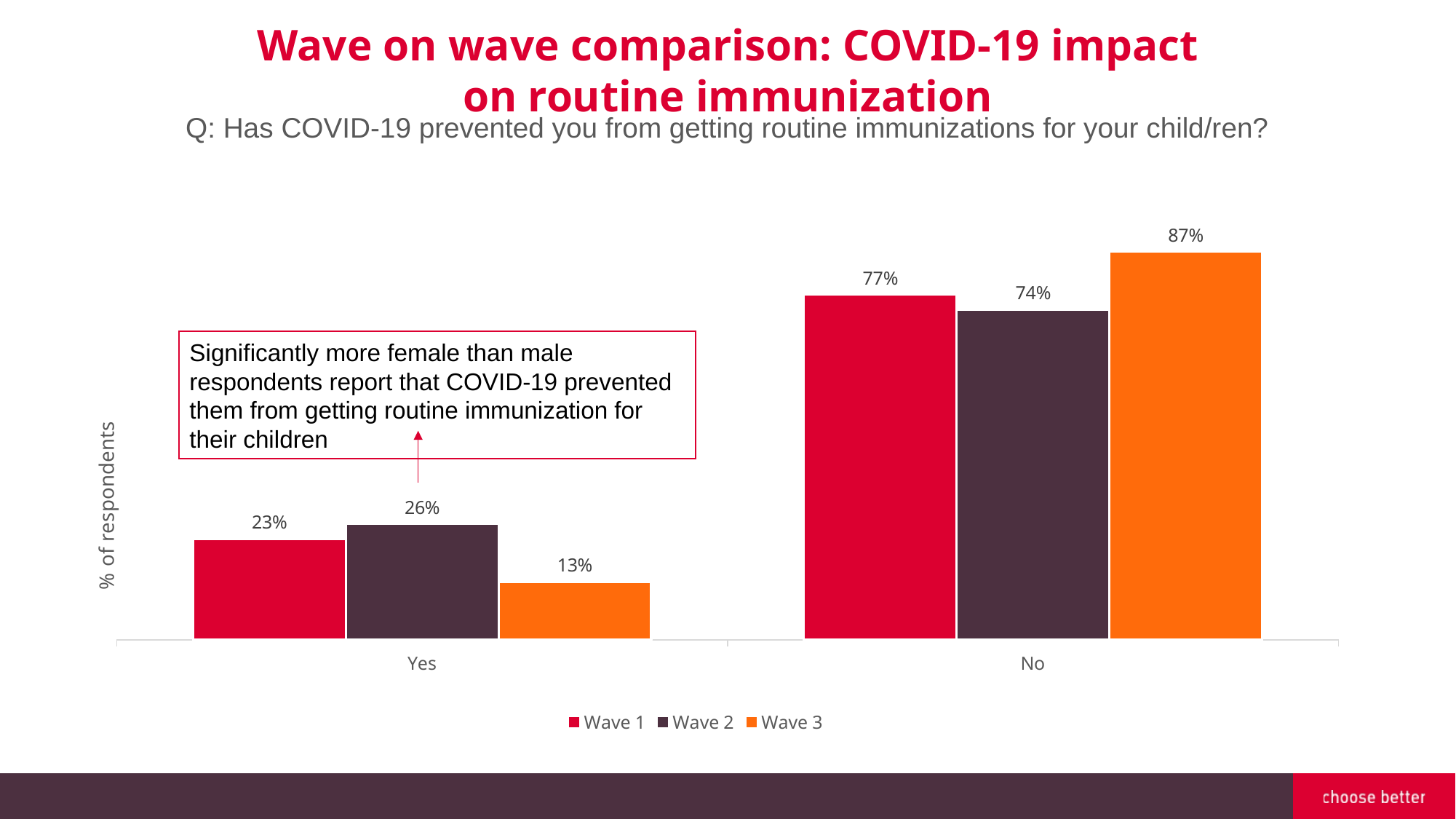
Which wave has the lowest value for the Yes category? Wave 3 What is the Wave 2 value for the Yes category? 26% What kind of chart is shown on the slide? Bar chart Which wave has the highest value for the No category? Wave 3 What is the difference between the Wave 2 and Wave 3 values for the Yes category? 13% How many series does the legend list? 3 What percentage of respondents answered No in Wave 3? 87% What percentage of respondents answered Yes in Wave 1? 23% Which is larger for the No category: Wave 1 or Wave 2? Wave 1 What is the label on the vertical axis? % of respondents How many categories are shown on the x axis? 2 What is the difference between the Wave 1 and Wave 3 values for the No category? 10%